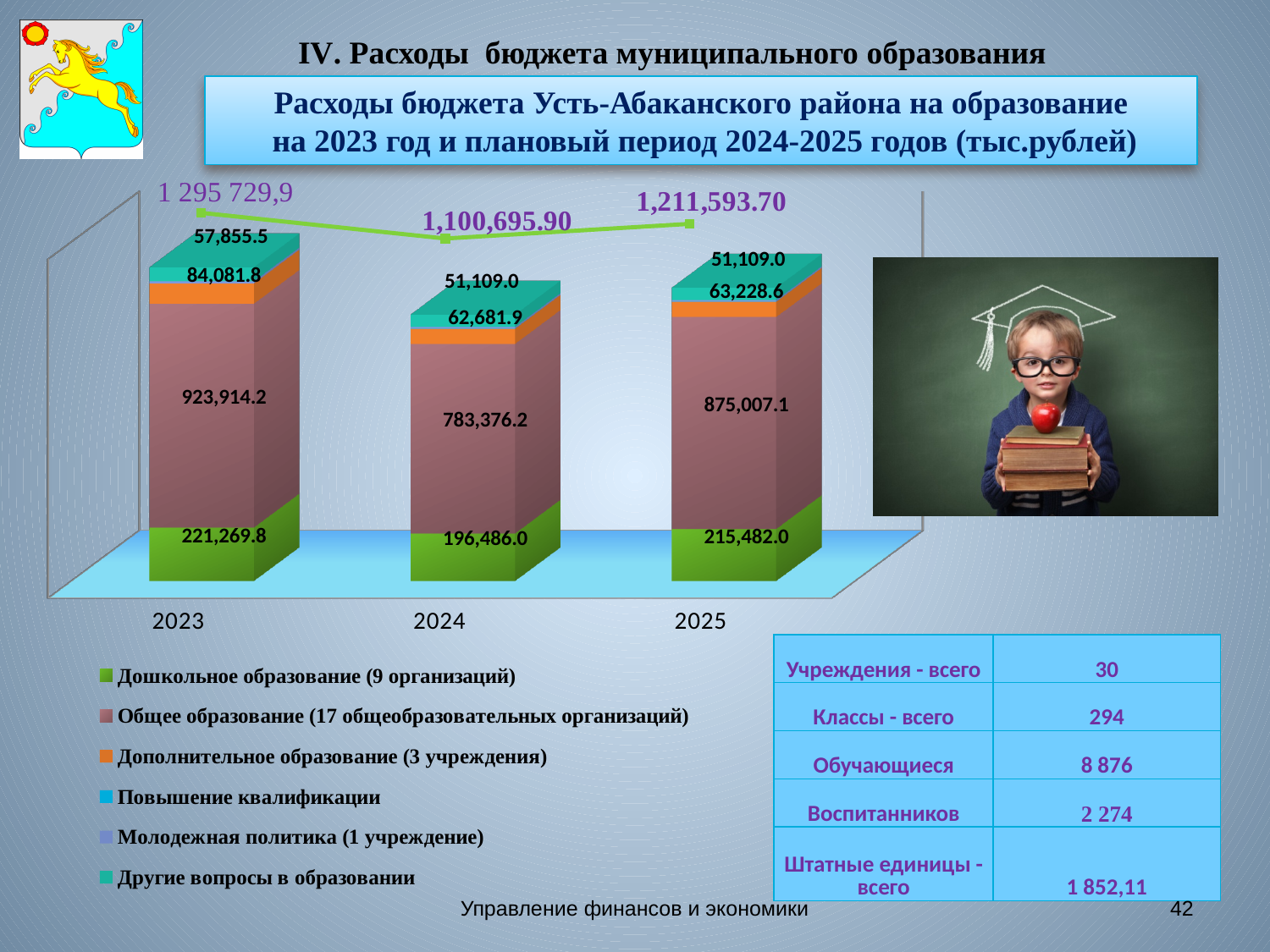
How many years are shown on the x axis of the chart? 3 Which year has the lowest total expenditure on education? 2024 What is the total shown on the line for 2025? 1,211,593.70 Which year has the highest total expenditure on education? 2023 What is the value for Дошкольное образование in 2024? 196,486.0 What is the difference between the Дошкольное образование values for 2025 and 2024? 18,996.0 Which year has the larger value for Дошкольное образование, 2023 or 2025? 2023 What is the value for Общее образование in 2023? 923,914.2 Does the total expenditure rise or fall from 2023 to 2024? fall How many series does the legend list? 6 What is the value for Дополнительное образование in 2025? 63,228.6 What is the difference between the Общее образование values for 2023 and 2024? 140,538.0